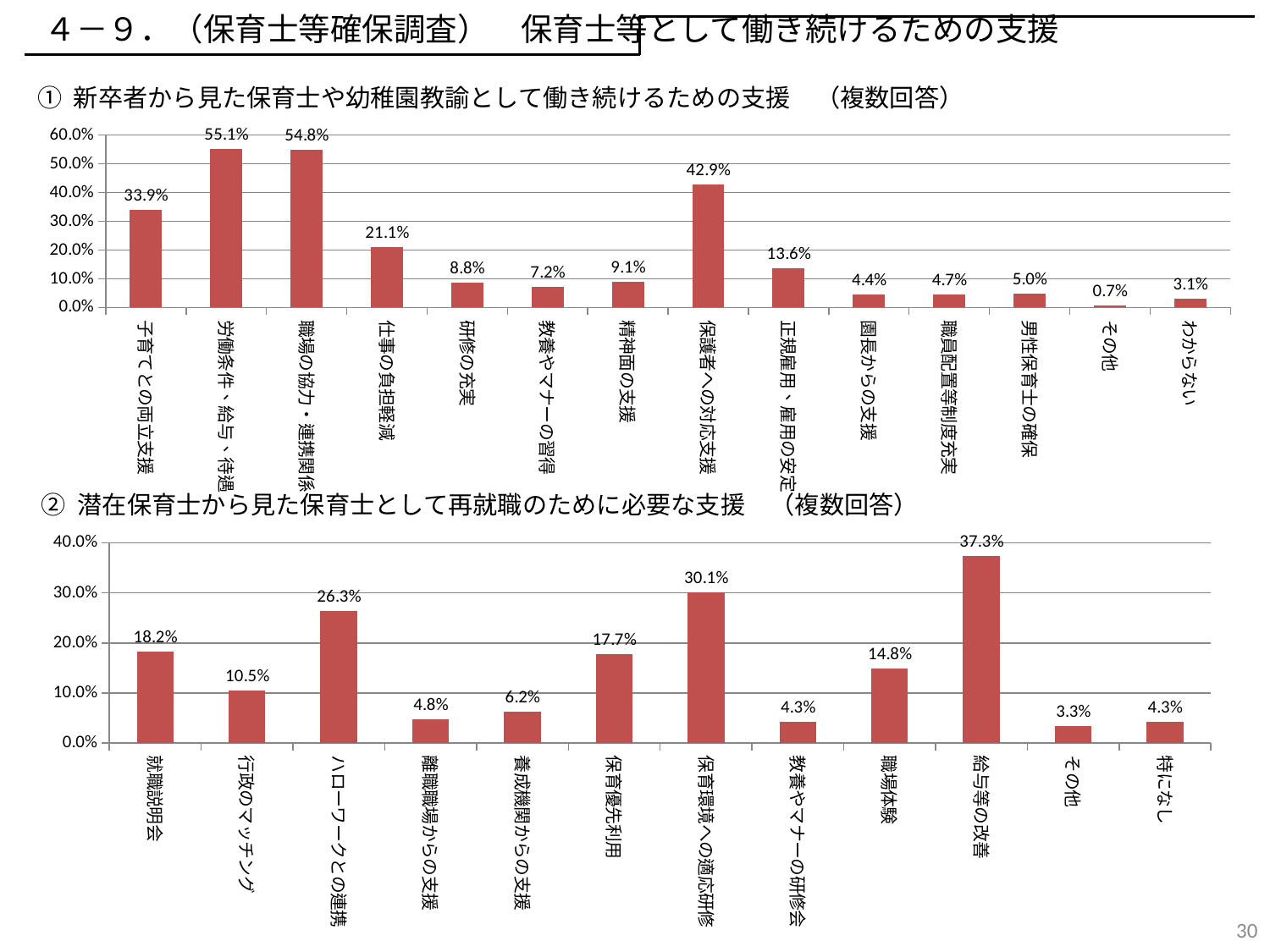
In the top chart (①), which category has the highest value? 労働条件・給与・待遇 In the bottom chart (② 潜在保育士から見た保育士として再就職のために必要な支援), what is the value for ハローワークとの連携? 26.3% In the top chart (①), what is the value for 仕事の負担軽減? 21.1% What type of chart is the bottom chart (②)? Bar chart In the bottom chart (②), which category has the highest value? 給与等の改善 In the bottom chart (②), which category has the lowest value? その他 In the top chart (①), which category has the lowest value? その他 In the top chart (① 新卒者から見た保育士や幼稚園教諭として働き続けるための支援), what is the value for 保護者への対応支援? 42.9% In the bottom chart (②), which is larger, 就職説明会 or 保育優先利用? 就職説明会 In the top chart (①), what is the difference between 労働条件・給与・待遇 and 職場の協力・連携関係? 0.3% In the top chart (①), how many categories are shown? 14 In the bottom chart (②), what is the difference between 給与等の改善 and 保育環境への適応研修? 7.2%